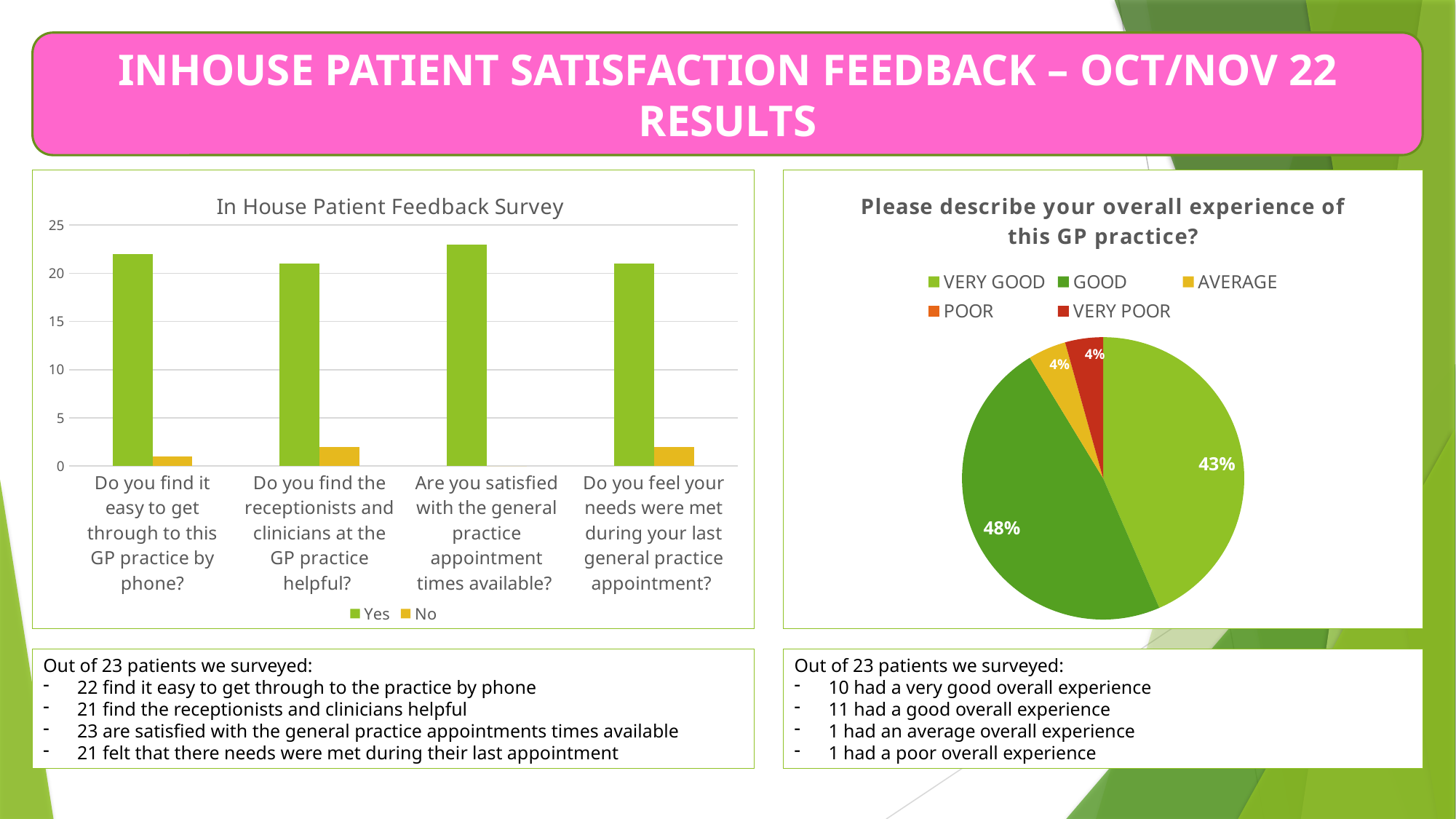
In the 'In House Patient Feedback Survey' chart, is the 'Yes' value for 'Are you satisfied with the general practice appointment times available?' greater or less than 20? greater In the pie chart 'Please describe your overall experience of this GP practice?', which category has the largest slice? GOOD What type of chart is the 'In House Patient Feedback Survey' chart? bar chart In the 'In House Patient Feedback Survey' chart, how many questions (categories) are shown on the x axis? 4 In the 'In House Patient Feedback Survey' chart, how many series does the legend list? 2 In the pie chart 'Please describe your overall experience of this GP practice?', what share is labelled for GOOD? 48% In the 'In House Patient Feedback Survey' chart, which question has the highest 'Yes' value? Are you satisfied with the general practice appointment times available? In the pie chart 'Please describe your overall experience of this GP practice?', how many categories does the legend list? 5 In the pie chart 'Please describe your overall experience of this GP practice?', what share is labelled for VERY GOOD? 43% In the 'In House Patient Feedback Survey' chart, is the 'No' value for 'Do you find the receptionists and clinicians at the GP practice helpful?' greater or less than 5? less In the 'In House Patient Feedback Survey' chart, which is larger for 'Do you find it easy to get through to this GP practice by phone?': the 'Yes' bar or the 'No' bar? Yes What type of chart is 'Please describe your overall experience of this GP practice?' pie chart